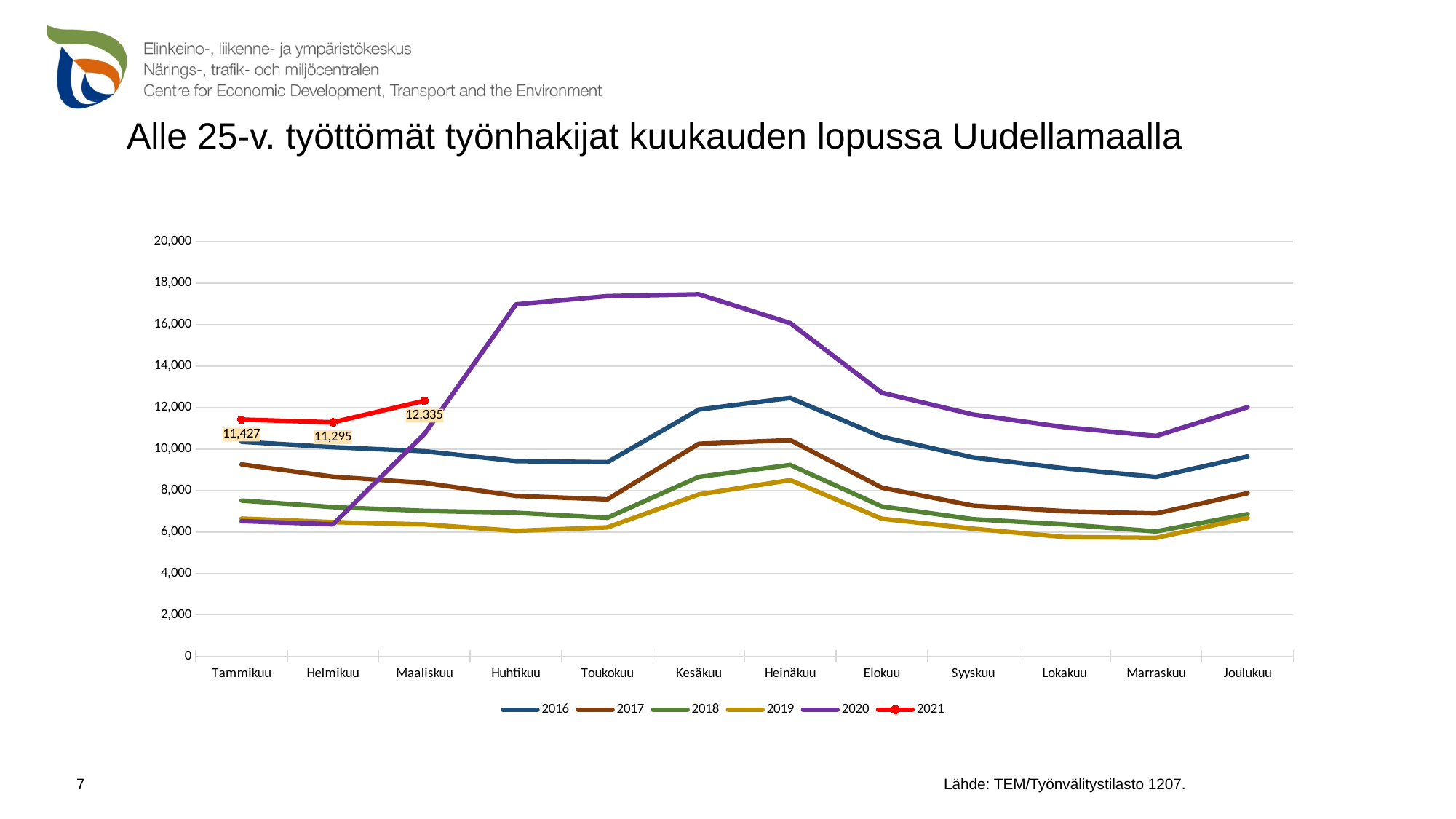
Is the value for 2020 in Kesäkuu greater or less than 16,000? greater Which is larger in Heinäkuu, the value for 2020 or the value for 2016? 2020 Does the 2021 line rise or fall from Helmikuu to Maaliskuu? Rises Among the labelled 2021 points, which month has the lowest value? Helmikuu How many months are shown on the x axis? 12 What is the value for 2021 in Maaliskuu? 12,335 What is the value for 2021 in Helmikuu? 11,295 Among the labelled 2021 points, which month has the highest value? Maaliskuu What is the difference between the 2021 values for Maaliskuu and Helmikuu? 1,040 What kind of chart is shown on the slide? Line chart What is the value for 2021 in Tammikuu? 11,427 How many series does the legend list? 6